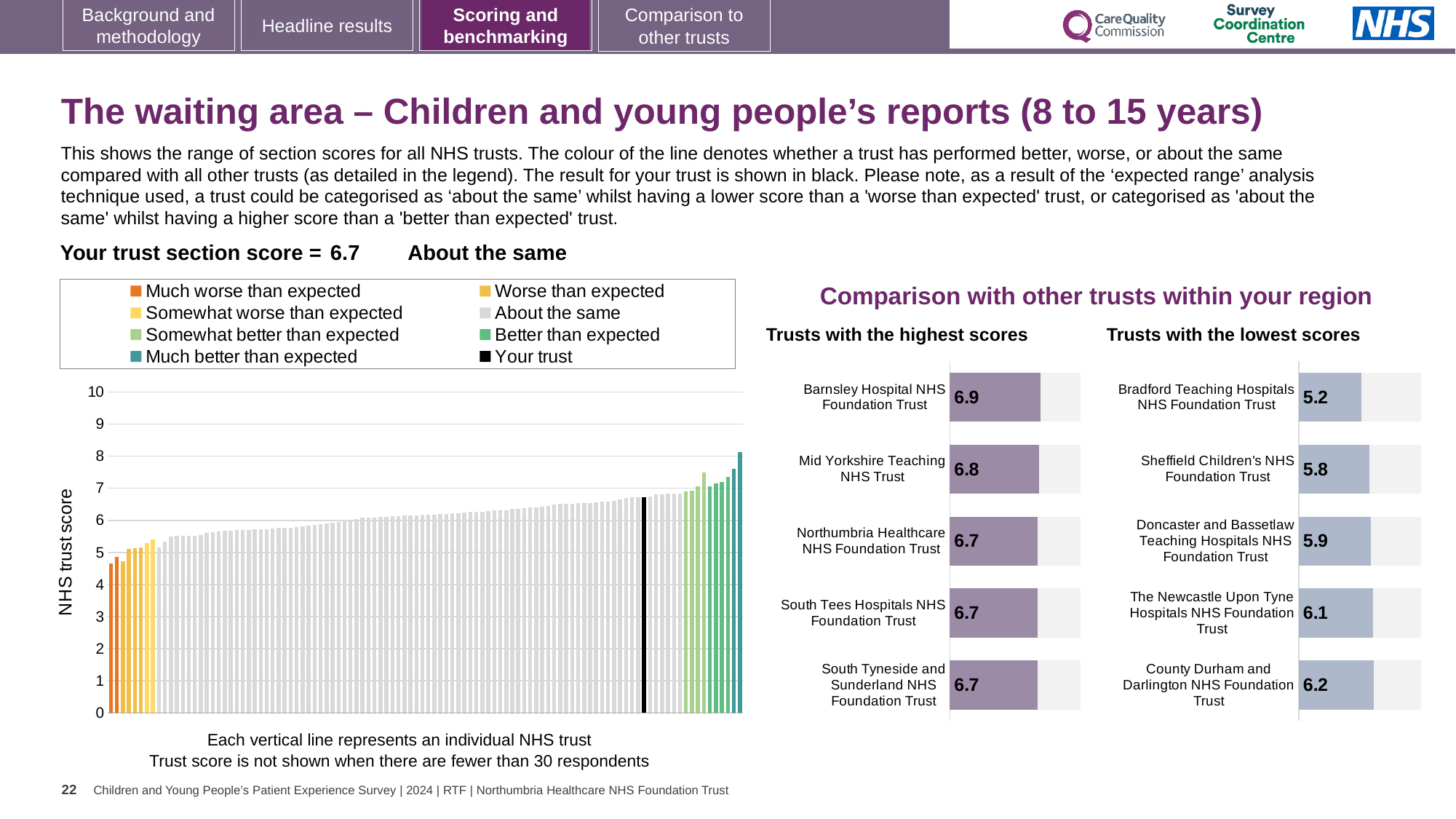
In the 'Trusts with the lowest scores' chart, what is the score for Bradford Teaching Hospitals NHS Foundation Trust? 5.2 In the 'Trusts with the highest scores' chart, which has the larger score: Mid Yorkshire Teaching NHS Trust or South Tees Hospitals NHS Foundation Trust? Mid Yorkshire Teaching NHS Trust In the 'Trusts with the lowest scores' chart, how many trusts are shown? 5 In the NHS trust score chart on the left, do the bar values rise or fall from left to right? rise In the 'Trusts with the highest scores' chart, what is the score for Barnsley Hospital NHS Foundation Trust? 6.9 In the 'Trusts with the lowest scores' chart, what is the difference between the scores of County Durham and Darlington NHS Foundation Trust and Bradford Teaching Hospitals NHS Foundation Trust? 1.0 In the 'Trusts with the highest scores' chart, which trust has the highest score? Barnsley Hospital NHS Foundation Trust In the NHS trust score chart on the left, what is the section score for your trust (the black bar)? 6.7 In the NHS trust score chart on the left, is the value of the lowest (leftmost) bar greater or less than 5? less In the 'Trusts with the lowest scores' chart, what is the score for The Newcastle Upon Tyne Hospitals NHS Foundation Trust? 6.1 In the 'Trusts with the lowest scores' chart, which trust has the lowest score? Bradford Teaching Hospitals NHS Foundation Trust How many entries does the legend above the NHS trust score chart list? 8